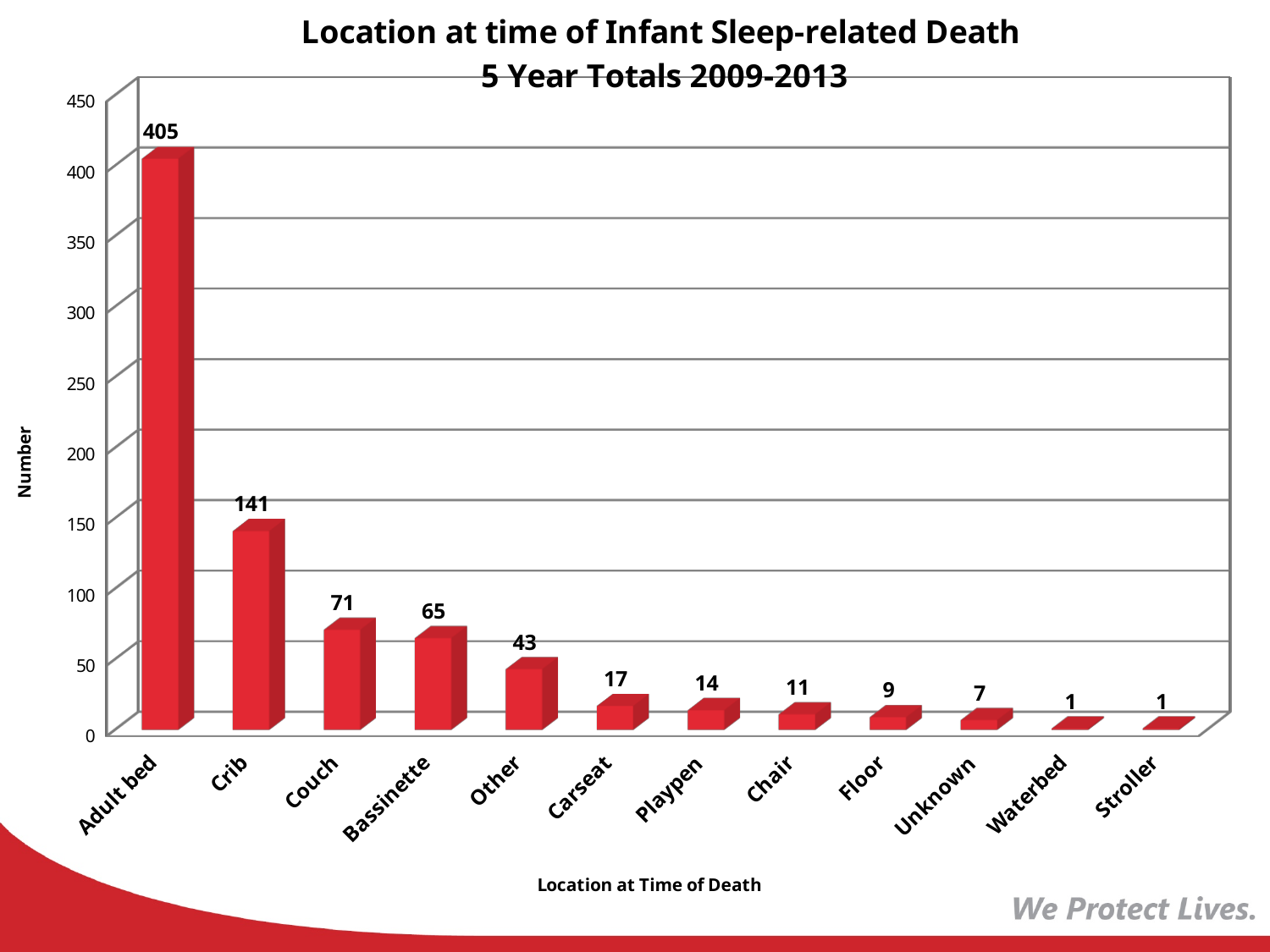
What is the value for Adult bed? 405 What is the value for Crib? 141 What is the value for Playpen? 14 Is the value for Crib greater or less than 100? greater Which is larger, the value for Other or the value for Carseat? Other How many location categories are shown on the x axis? 12 What kind of chart is shown on the slide? Bar chart Which location has the highest number? Adult bed What is the difference between the values for Adult bed and Crib? 264 What is the title of the chart? Location at time of Infant Sleep-related Death 5 Year Totals 2009-2013 What is the value for Bassinette? 65 What is the difference between the values for Couch and Bassinette? 6